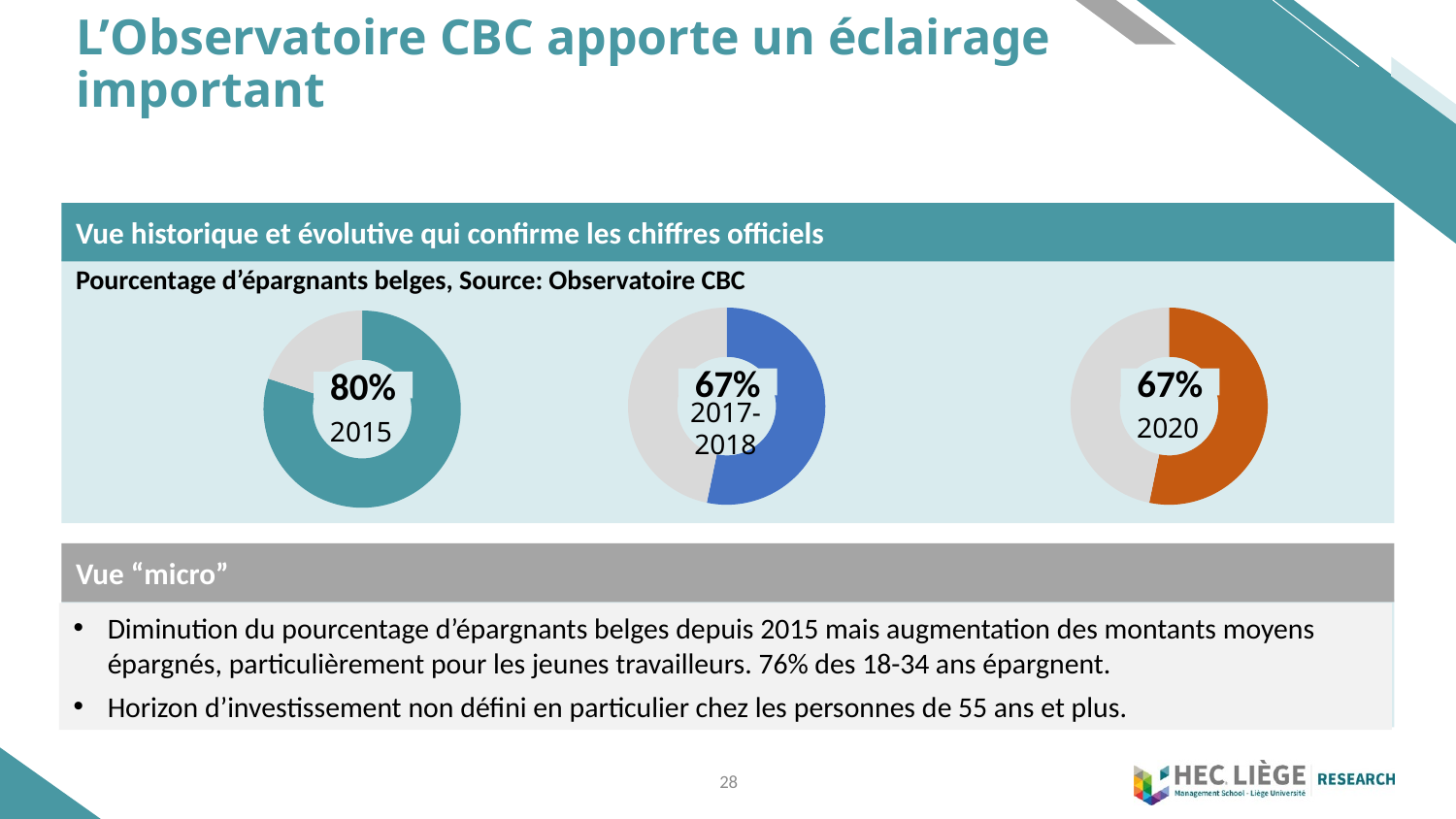
What is the difference between the percentage shown for 2015 and the percentage shown for 2020? 13 percentage points Is the percentage shown for 2017-2018 the same as the percentage shown for 2020? Yes, both 67% What percentage is shown in the 2017-2018 donut chart? 67% How many donut charts are shown on the slide? 3 Does the percentage of Belgian savers rise or fall from 2015 to 2020 across the charts? Fall Which is larger, the percentage shown for 2015 or the percentage shown for 2017-2018? 2015 What kind of charts are used to show the percentage of Belgian savers? Donut (pie) charts What percentage is shown in the 2020 donut chart? 67% Which year's donut chart shows the highest percentage of Belgian savers? 2015 What percentage of Belgian savers is shown in the 2015 donut chart? 80% According to the label above the charts, what is the source of the data? Observatoire CBC What colour is the filled portion of the 2020 donut chart? Orange